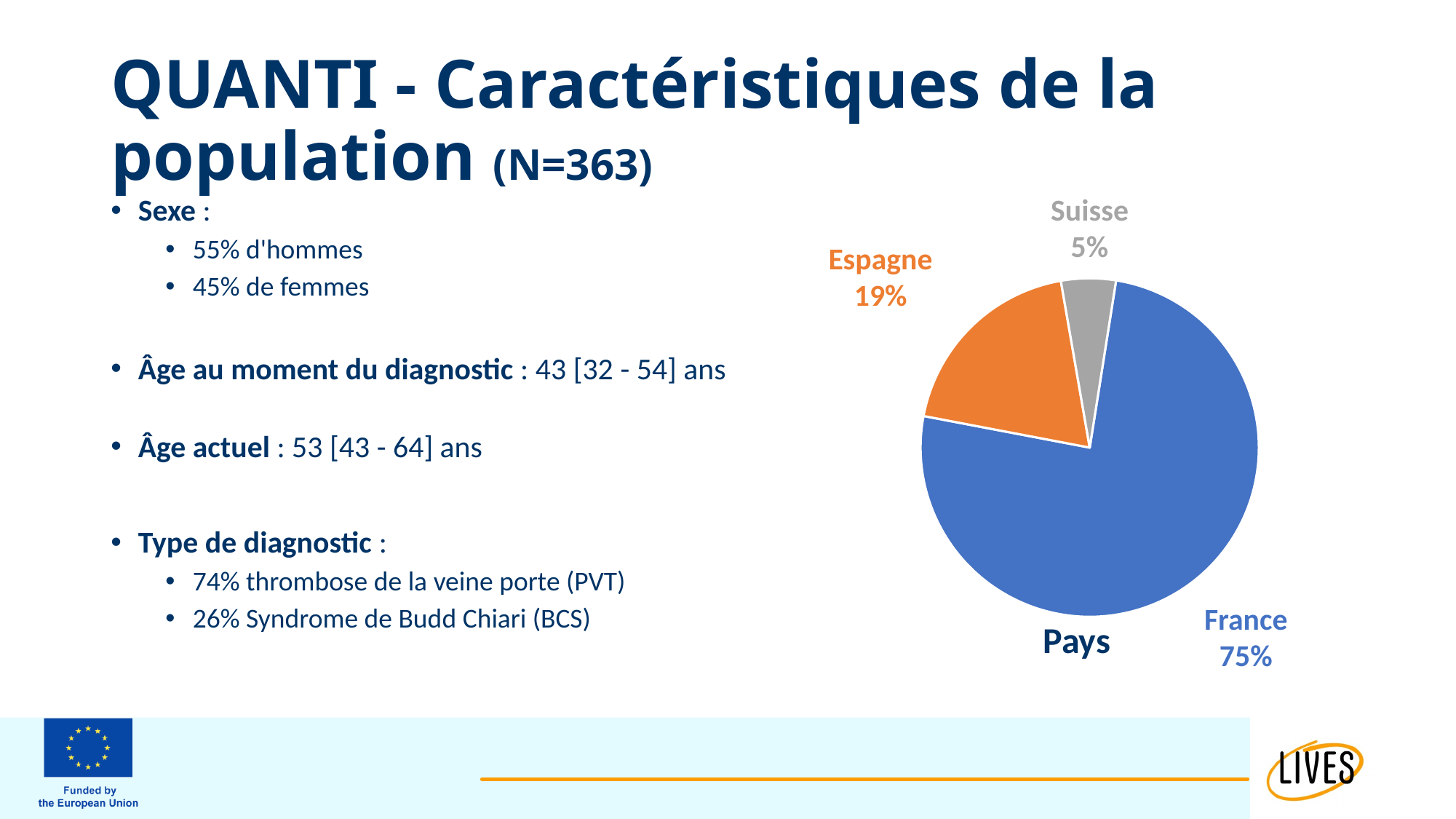
What share of the pie does Suisse represent? 5% Which slice is larger, Espagne or Suisse? Espagne Which country has the largest slice of the pie? France What is the difference in percentage points between Espagne and Suisse? 14 Which country has the smallest slice of the pie? Suisse What kind of chart is shown on the slide? pie chart What colour is the slice for Espagne? orange What share of the pie does France represent? 75% What share of the pie does Espagne represent? 19% What is the difference in percentage points between France and Espagne? 56 How many slices does the pie chart have? 3 What is the title of the pie chart? Pays